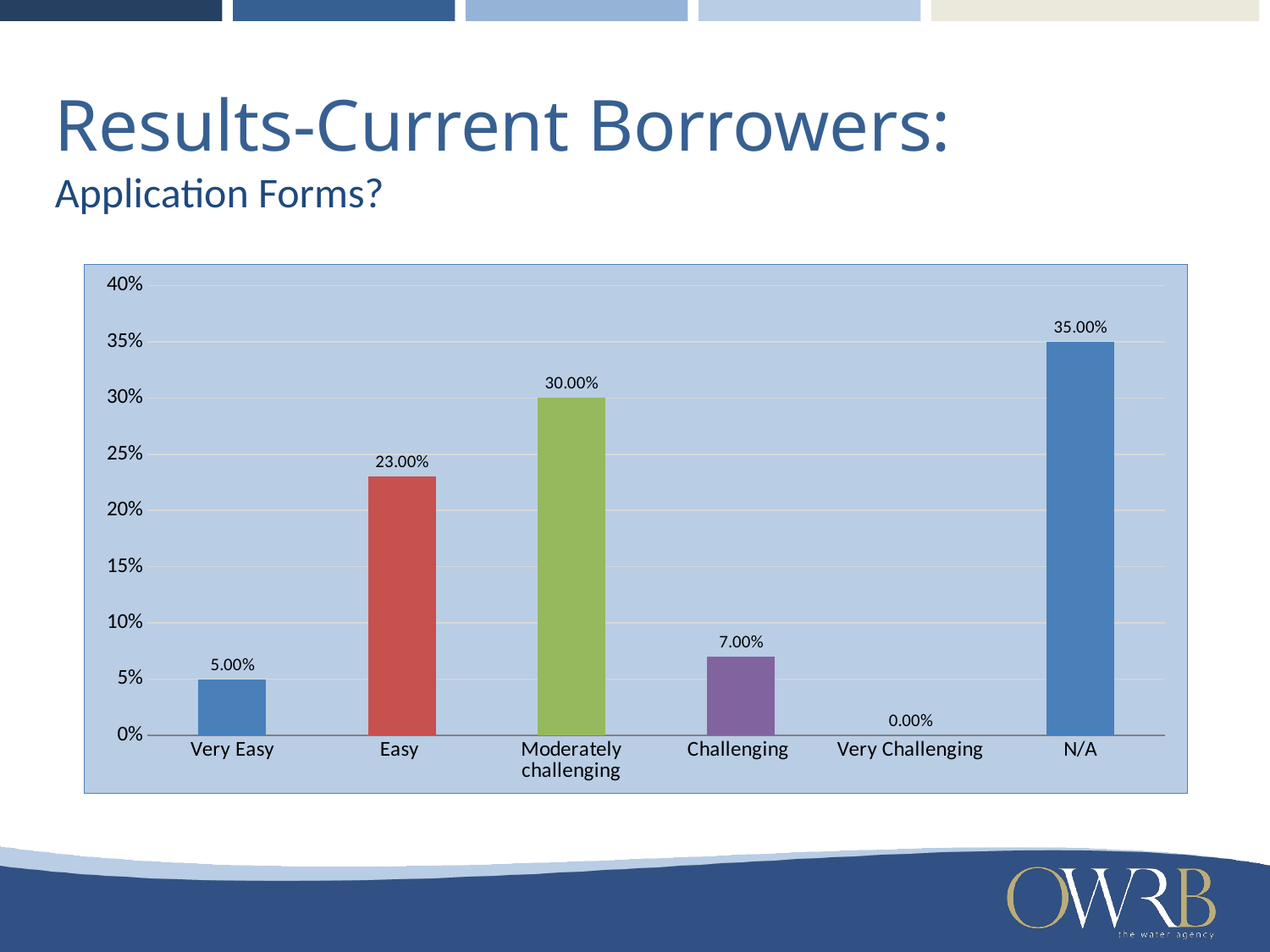
What kind of chart is shown on the slide? bar chart Which category has the highest value? N/A Which is larger, the value for Easy or the value for Challenging? Easy What is the subtitle shown above the chart? Application Forms? What is the value for Moderately challenging? 30.00% What is the value for Easy? 23.00% What is the value for Challenging? 7.00% How many categories are shown on the x axis? 6 Is the value for Very Easy greater or less than 10%? less Which category has the lowest value? Very Challenging What is the value for Very Challenging? 0.00% What is the difference between the values for N/A and Moderately challenging? 5.00%